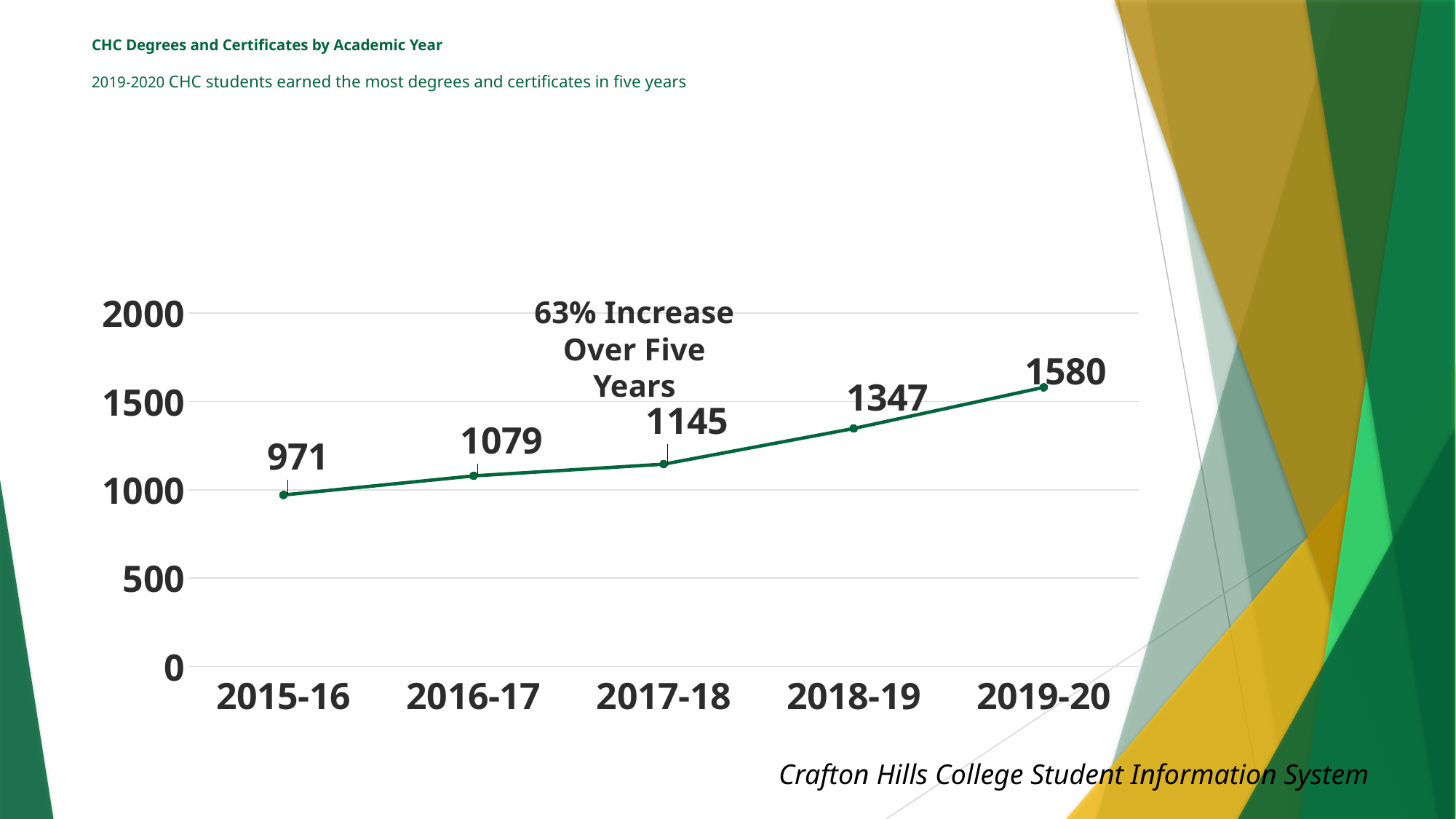
What is the difference between the values for 2018-19 and 2017-18? 202 Is the value for 2019-20 greater or less than 1500? greater What is the value for 2017-18? 1145 Which is larger, the value for 2016-17 or the value for 2018-19? 2018-19 What kind of chart is shown on the slide? line chart What is the difference between the values for 2019-20 and 2015-16? 609 Which academic year has the highest value? 2019-20 Do the values rise or fall from 2015-16 to 2019-20? rise How many academic years are plotted on the chart? 5 What is the value for 2015-16? 971 What is the value for 2019-20? 1580 Which academic year has the lowest value? 2015-16